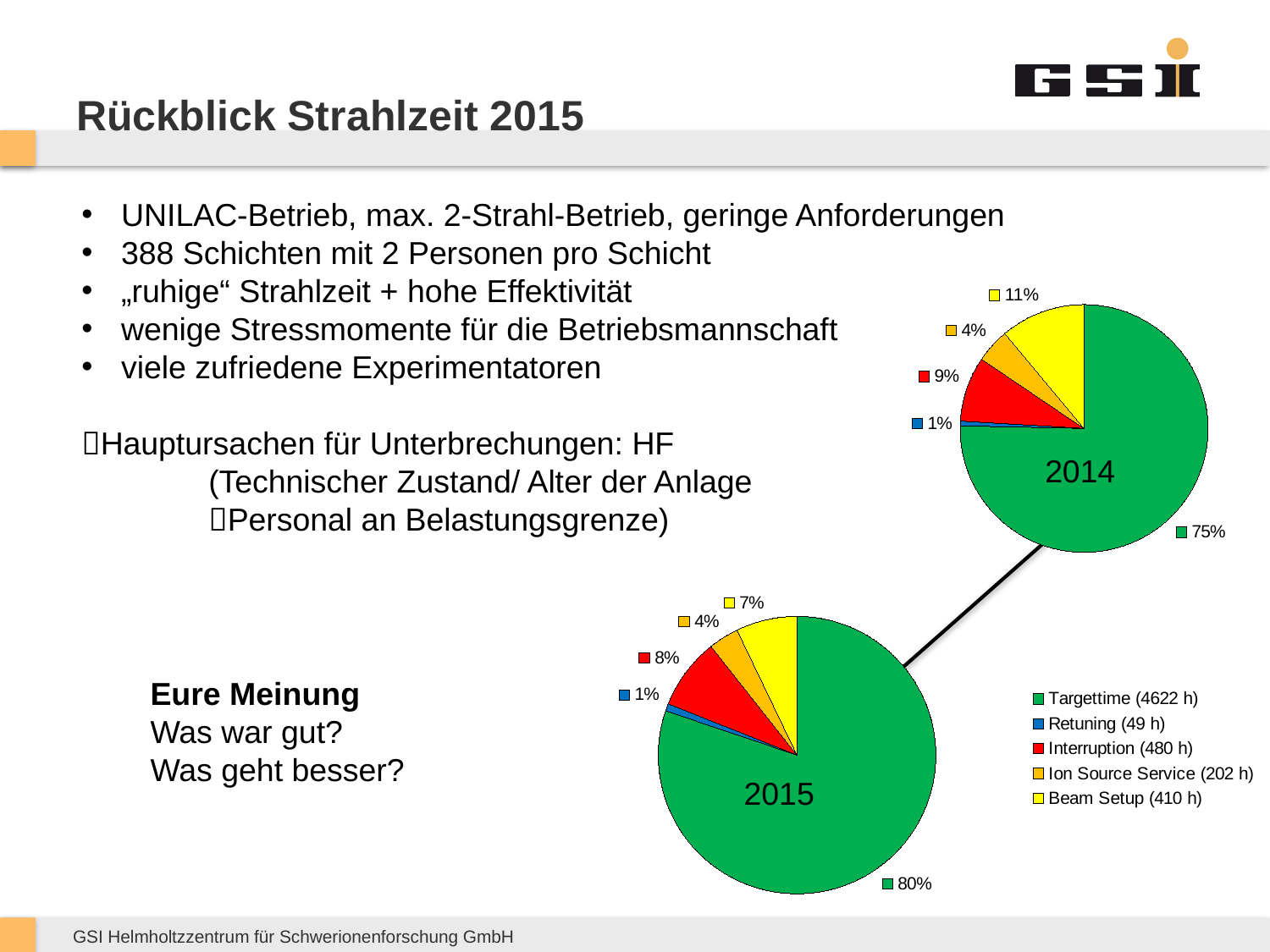
In the 2015 pie chart, what percentage is shown for the Interruption (red) slice? 8% In the 2015 pie chart, which category has the largest slice? Targettime According to the legend, how many hours are given for Interruption? 480 h What type of chart is used to show the 2014 and 2015 data? Pie chart In the 2014 pie chart, which category has the smallest slice? Retuning Which colour represents Beam Setup in the pie charts? Yellow In the 2015 pie chart, what percentage is shown for the Targettime slice? 80% By how many percentage points is the Targettime share in the 2015 pie chart higher than in the 2014 pie chart? 5 percentage points Is the Interruption share larger in the 2014 pie chart or the 2015 pie chart? 2014 How many categories does the legend list for the pie charts? 5 In the 2014 pie chart, what percentage is shown for the Targettime slice? 75%